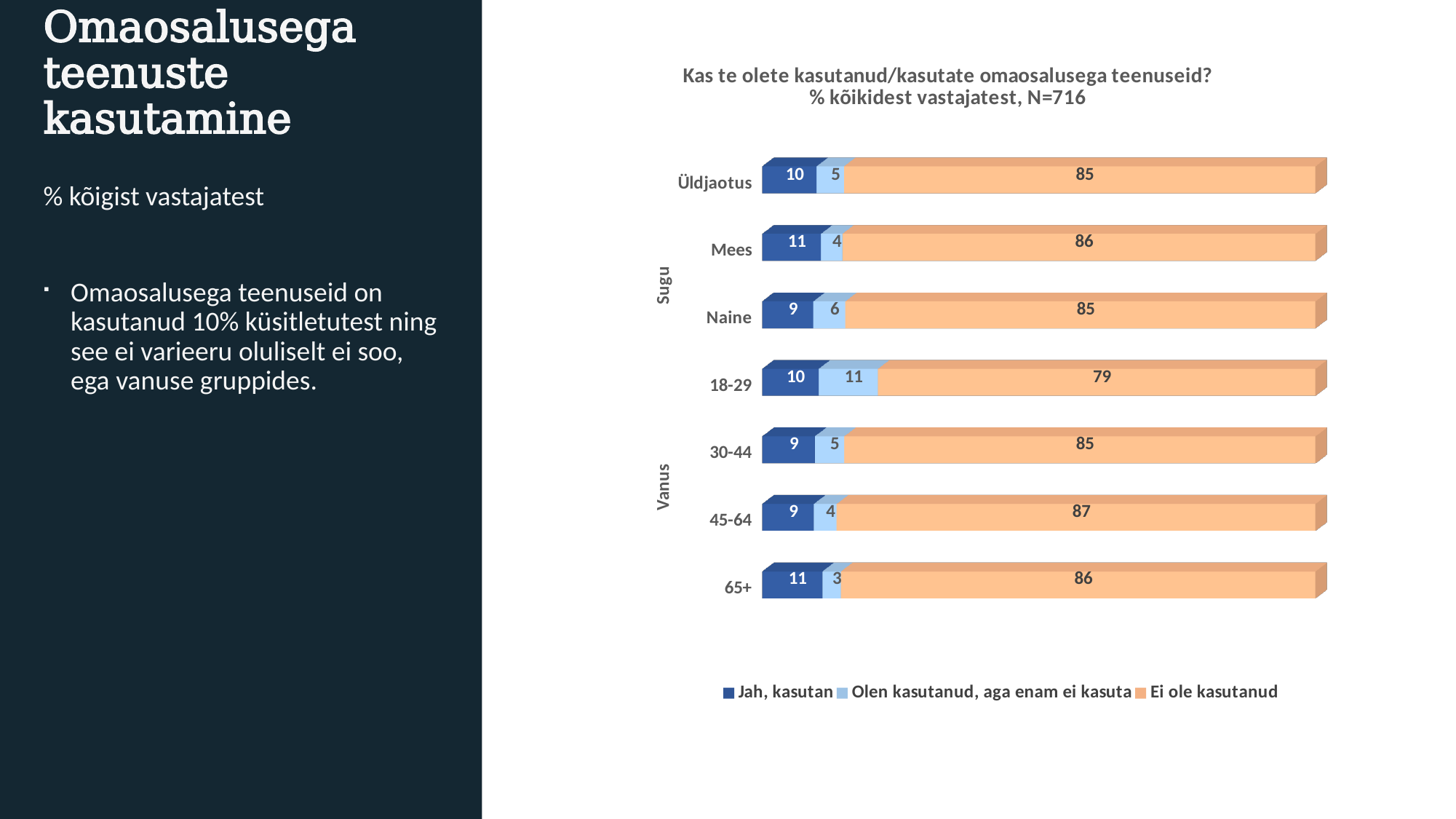
What is the difference between the "Ei ole kasutanud" values for 45-64 and 18-29? 8 What is the value of "Jah, kasutan" for Mees? 11 How many categories are shown on the chart? 7 Which category has the highest value for "Ei ole kasutanud"? 45-64 Which category has the lowest value for "Olen kasutanud, aga enam ei kasuta"? 65+ What kind of chart is shown on the slide? Stacked bar chart What is the value of "Olen kasutanud, aga enam ei kasuta" for 18-29? 11 What is the value of "Ei ole kasutanud" for Üldjaotus? 85 Which category has the lowest value for "Ei ole kasutanud"? 18-29 Which is larger: the "Olen kasutanud, aga enam ei kasuta" value for Naine or for Mees? Naine How many series does the legend list? 3 What is the value of "Ei ole kasutanud" for 45-64? 87